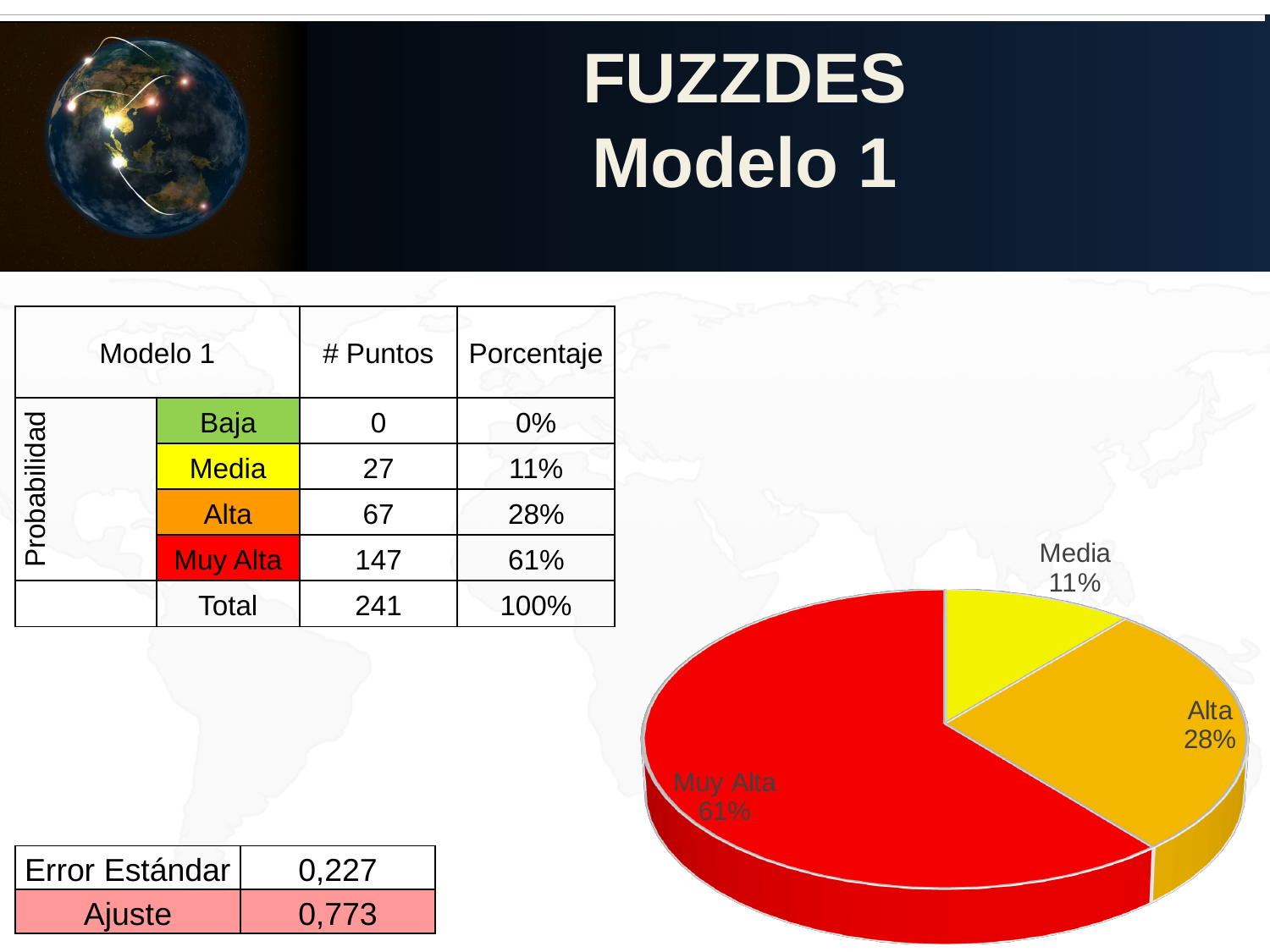
What is the difference in percentage points between the Alta and Media slices? 17% Which labelled slice of the pie chart is the smallest? Media What colour is the Media slice in the pie chart? yellow What colour is the Muy Alta slice in the pie chart? red What is the difference in percentage points between the Muy Alta and Alta slices? 33% Which slice is larger, Alta or Media? Alta What share of the pie does the Muy Alta slice represent? 61% How many labelled slices does the pie chart have? 3 What kind of chart is shown on the slide? pie chart What share of the pie does the Alta slice represent? 28% What share of the pie does the Media slice represent? 11% Which slice of the pie chart is the largest? Muy Alta